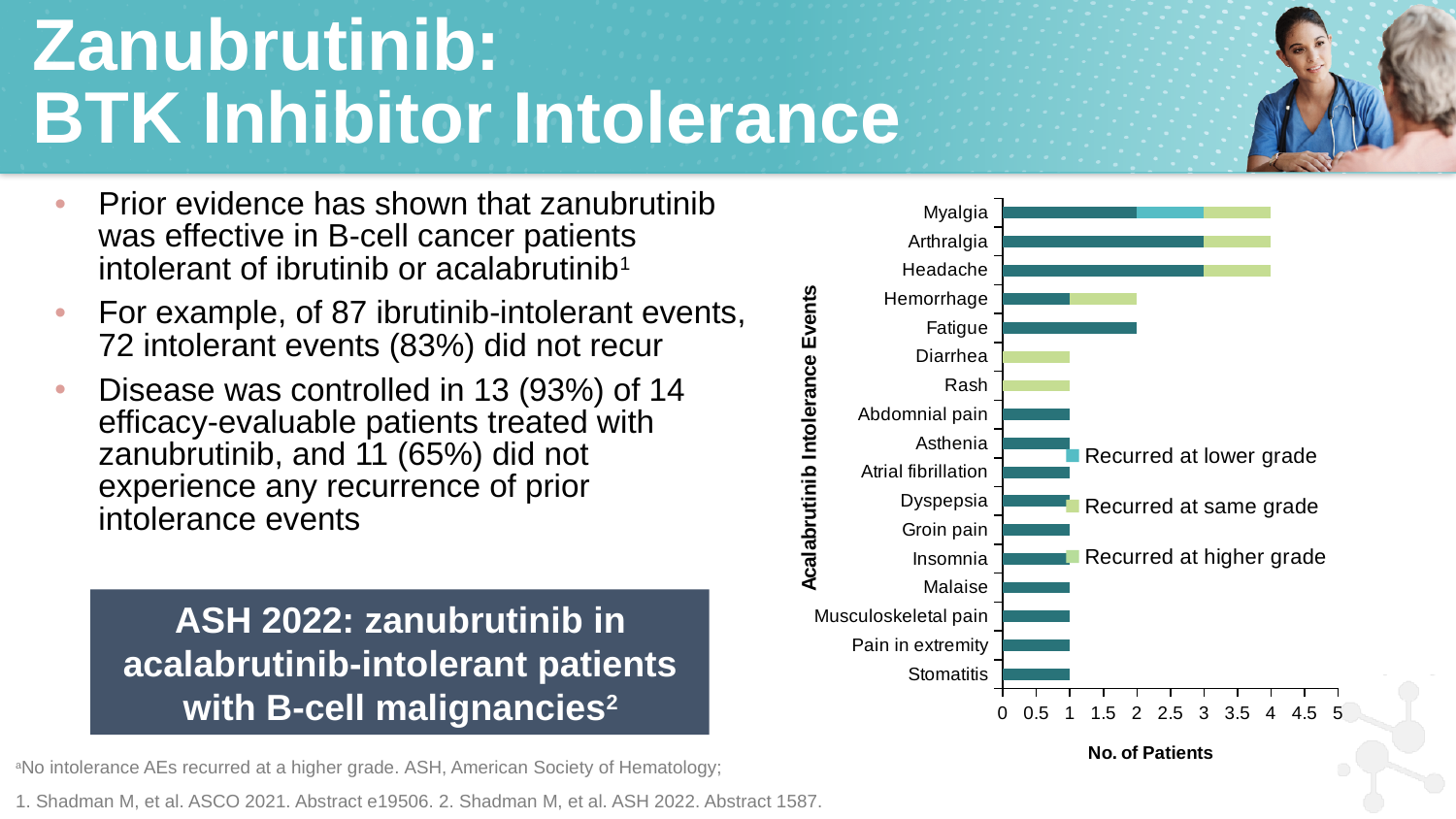
What is the difference in total patients between Headache and Hemorrhage? 2 Which has more patients, Fatigue or Diarrhea? Fatigue What kind of chart is shown on the slide? Bar chart How many series does the chart legend list? 3 Which legend entry is shown in light blue? Recurred at lower grade What is the total number of patients for the Myalgia bar? 4 What is the number of patients for Stomatitis? 1 What is the number of patients for Fatigue? 2 What is the total number of patients for the Hemorrhage bar? 2 How many acalabrutinib intolerance events are listed on the y axis of the chart? 17 What is the label of the x axis of the chart? No. of Patients Is the total number of patients for Arthralgia greater or less than 3? greater